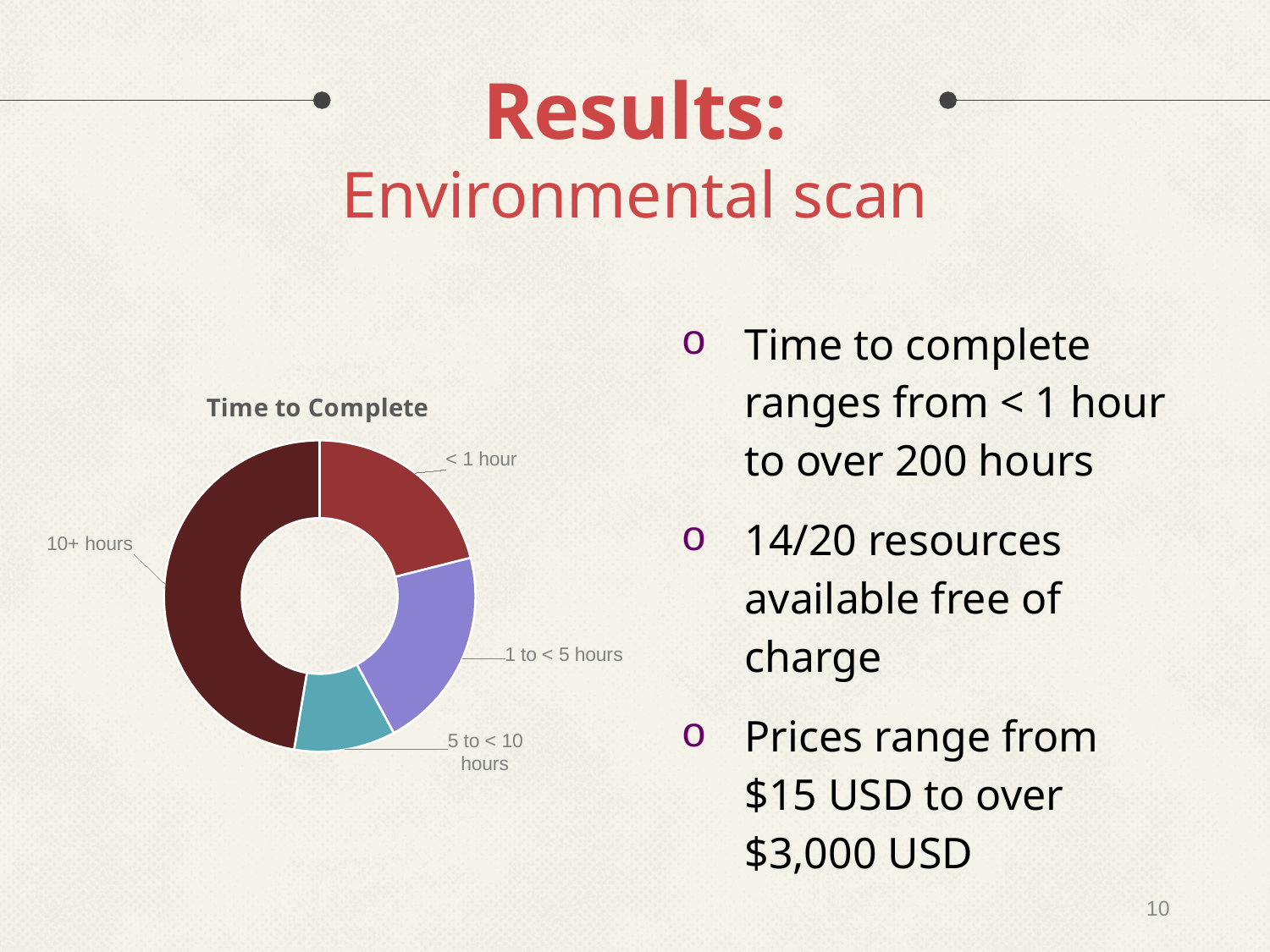
How many categories does the Time to Complete chart show? 4 Which is larger in the Time to Complete chart: the share for 10+ hours or the share for 5 to < 10 hours? 10+ hours Which is larger in the Time to Complete chart: the share for 10+ hours or the share for < 1 hour? 10+ hours Which category has the smallest share in the Time to Complete chart? 5 to < 10 hours Which category has the largest share in the Time to Complete chart? 10+ hours Which is larger in the Time to Complete chart: the share for 1 to < 5 hours or the share for 5 to < 10 hours? 1 to < 5 hours What colour is the 5 to < 10 hours segment in the Time to Complete chart? teal What is the title of the chart? Time to Complete What type of chart is shown on the slide? doughnut chart